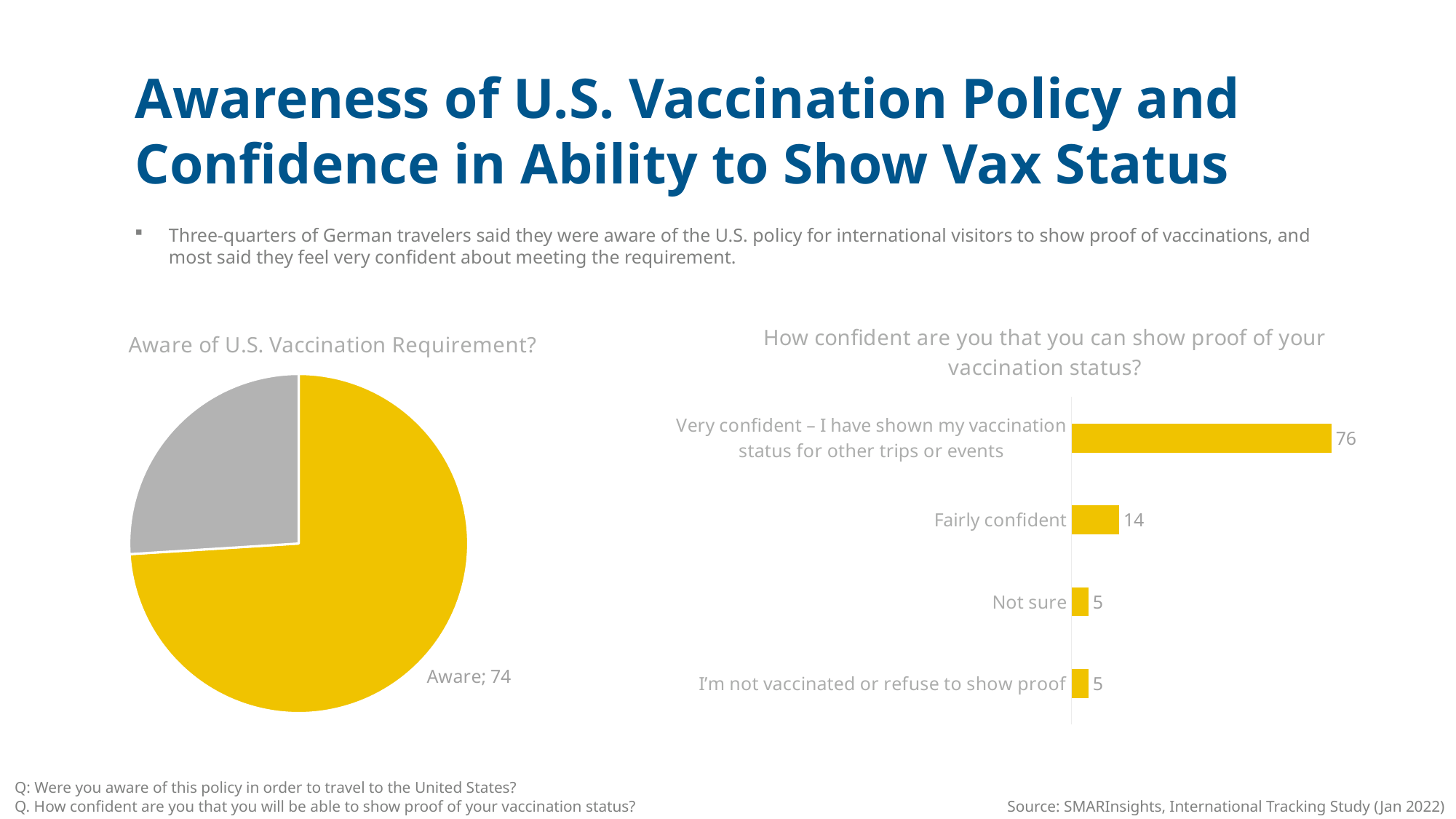
In the bar chart on the right, how many categories are shown? 4 What kind of chart is the chart on the right titled 'How confident are you that you can show proof of your vaccination status?'? bar chart In the bar chart on the right, what is the difference between the values for 'Very confident' and 'Fairly confident'? 62 In the pie chart 'Aware of U.S. Vaccination Requirement?', what value is shown for the 'Aware' slice? 74 In the bar chart on the right, what is the value for 'I'm not vaccinated or refuse to show proof'? 5 In the bar chart on the right, which category has the highest value? Very confident – I have shown my vaccination status for other trips or events In the bar chart on the right, which is larger: the value for 'Fairly confident' or the value for 'Not sure'? Fairly confident In the bar chart on the right, what is the value for 'Not sure'? 5 In the pie chart on the left, what colour is the 'Aware' slice? yellow In the bar chart on the right, what is the value for 'Very confident – I have shown my vaccination status for other trips or events'? 76 What kind of chart is the chart on the left titled 'Aware of U.S. Vaccination Requirement?'? pie chart In the bar chart on the right, what is the value for 'Fairly confident'? 14